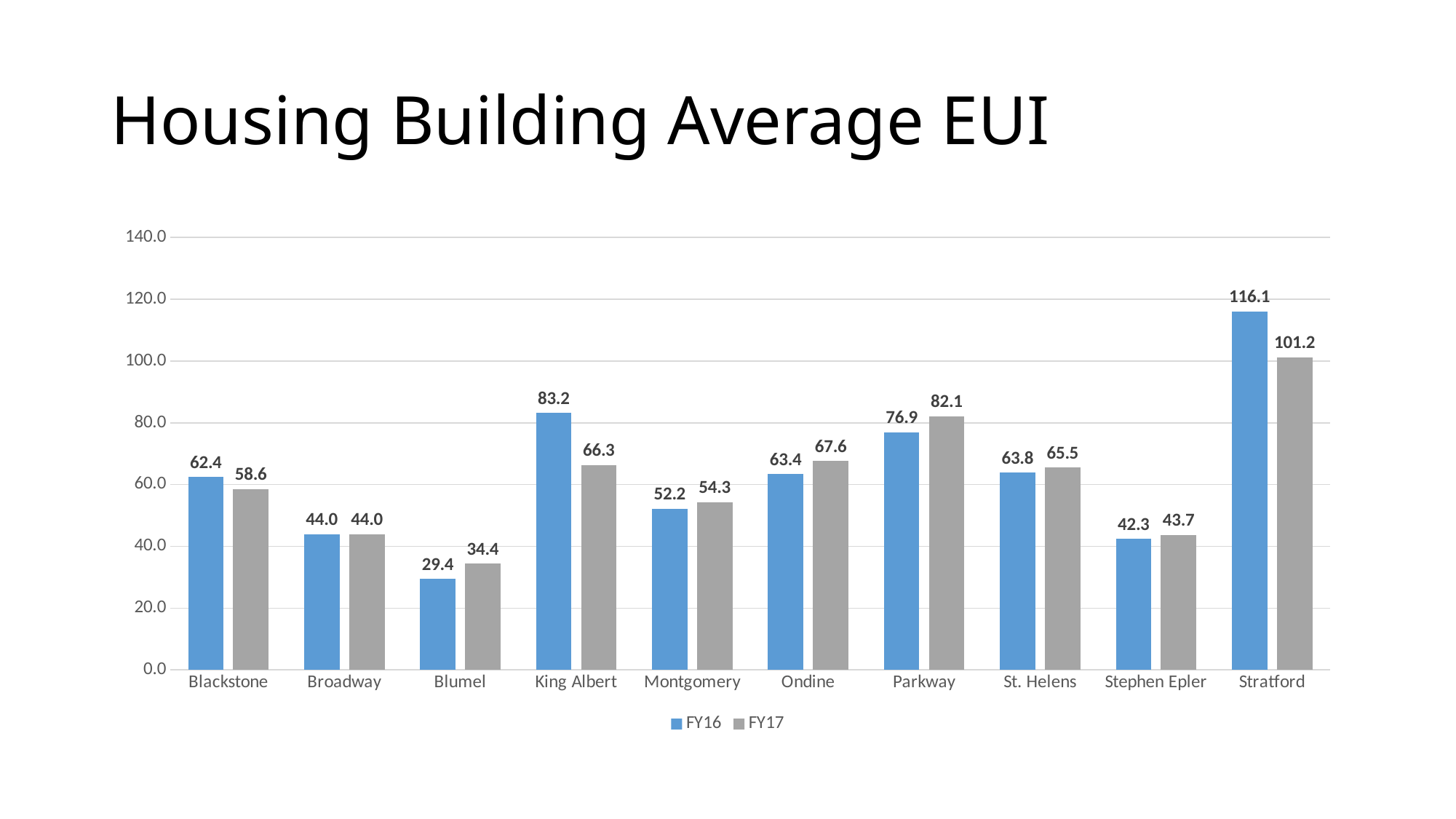
What is the difference between the FY16 and FY17 values for Stratford? 14.9 How many series does the legend list? 2 What kind of chart is shown on the slide? Bar chart How many buildings are shown on the x axis? 10 Which building has the highest FY16 value? Stratford What is the title of the chart? Housing Building Average EUI Which building has the lowest FY17 value? Blumel Which is larger for Parkway, the FY16 value or the FY17 value? FY17 What is the difference between the FY16 and FY17 values for King Albert? 16.9 What is the FY17 value for Stratford? 101.2 What is the FY17 value for Blumel? 34.4 What is the FY16 value for King Albert? 83.2